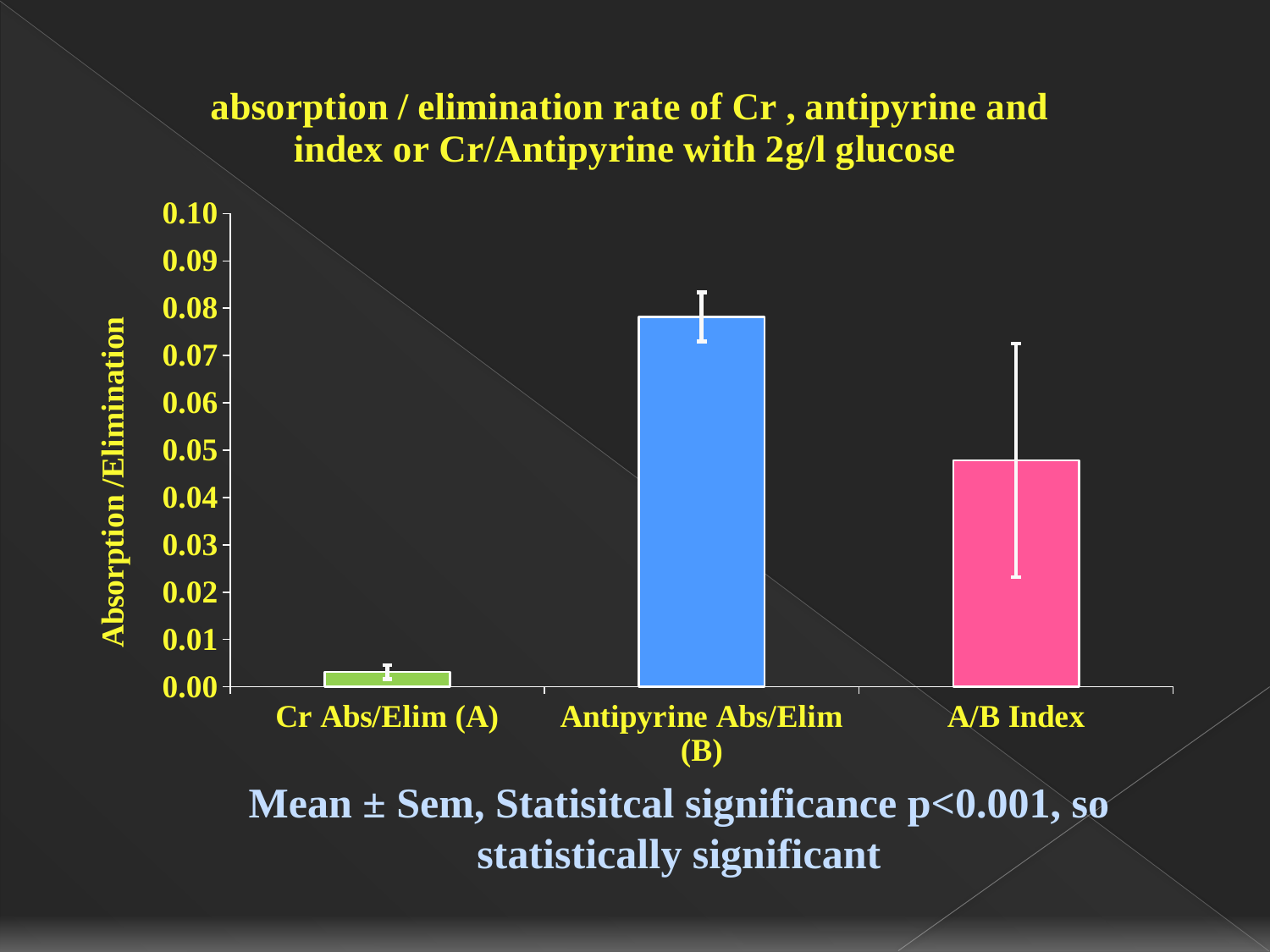
Is the value for Cr Abs/Elim (A) greater or less than 0.01? less Which category has the highest bar? Antipyrine Abs/Elim (B) What is the label on the y axis of the chart? Absorption /Elimination Is the value for A/B Index greater or less than 0.04? greater Is the value for Antipyrine Abs/Elim (B) greater or less than 0.07? greater Which is larger, the value for Cr Abs/Elim (A) or the value for A/B Index? A/B Index What kind of chart is shown on the slide? bar chart How many categories are plotted on the x axis? 3 Which category has the lowest bar? Cr Abs/Elim (A) Which is larger, the value for Antipyrine Abs/Elim (B) or the value for A/B Index? Antipyrine Abs/Elim (B) What colour is the bar for A/B Index? pink